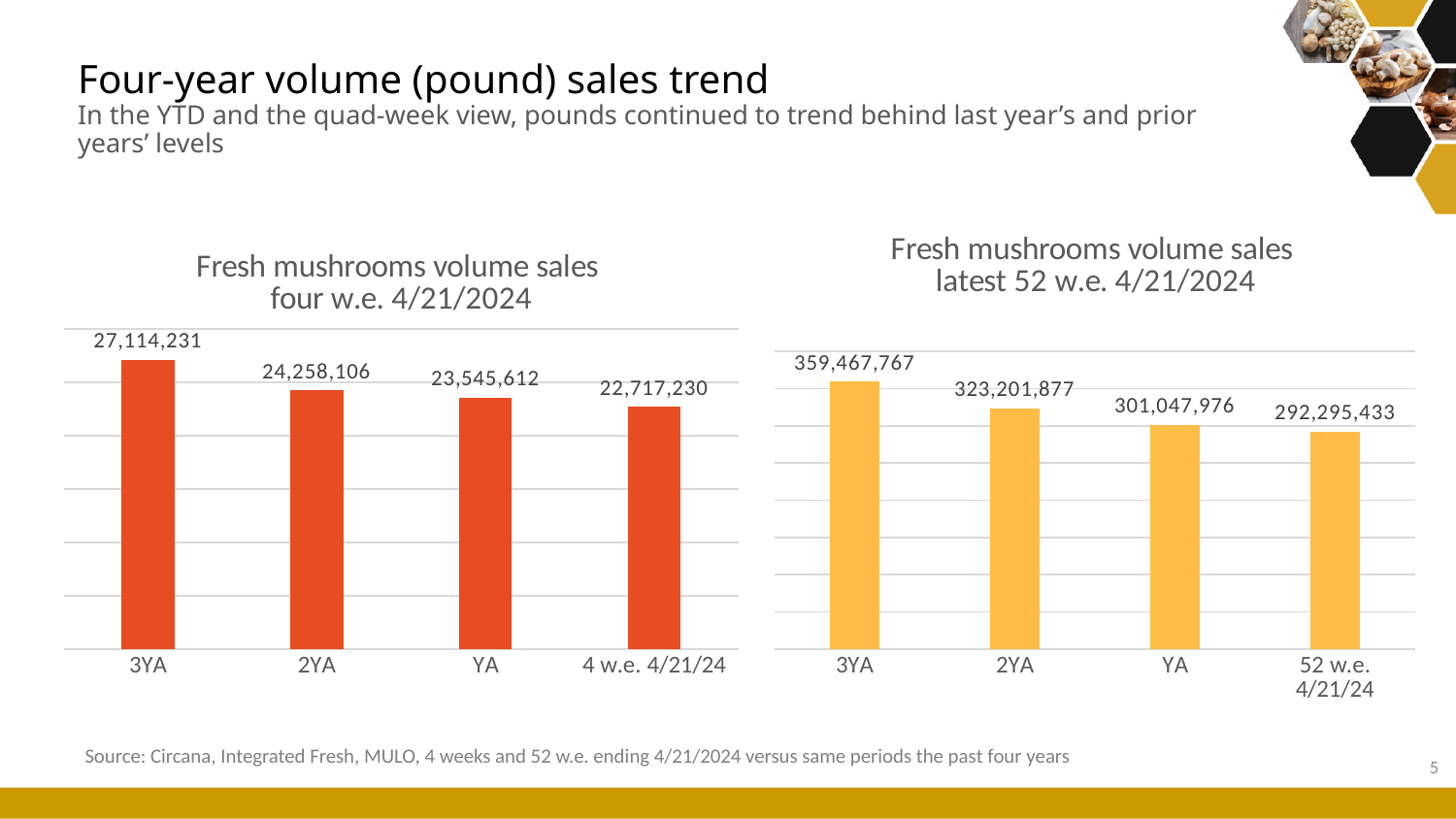
In the 'Fresh mushrooms volume sales four w.e. 4/21/2024' chart, which is larger, the value for 2YA or the value for YA? 2YA In the 'Fresh mushrooms volume sales four w.e. 4/21/2024' chart, what is the value for 3YA? 27,114,231 In the 'Fresh mushrooms volume sales four w.e. 4/21/2024' chart, which category has the highest value? 3YA How many categories are shown in the 'Fresh mushrooms volume sales latest 52 w.e. 4/21/2024' chart? 4 In the 'Fresh mushrooms volume sales four w.e. 4/21/2024' chart, what is the difference between the 3YA value and the 4 w.e. 4/21/24 value? 4,397,001 In the 'Fresh mushrooms volume sales four w.e. 4/21/2024' chart, what is the value for 4 w.e. 4/21/24? 22,717,230 What kind of chart is the 'Fresh mushrooms volume sales four w.e. 4/21/2024' chart? Bar chart In the 'Fresh mushrooms volume sales latest 52 w.e. 4/21/2024' chart, what is the difference between the 2YA value and the YA value? 22,153,901 In the 'Fresh mushrooms volume sales latest 52 w.e. 4/21/2024' chart, do the values rise or fall from 3YA to 52 w.e. 4/21/24? Fall In the 'Fresh mushrooms volume sales latest 52 w.e. 4/21/2024' chart, what is the value for YA? 301,047,976 In the 'Fresh mushrooms volume sales latest 52 w.e. 4/21/2024' chart, what is the value for 2YA? 323,201,877 In the 'Fresh mushrooms volume sales latest 52 w.e. 4/21/2024' chart, which category has the lowest value? 52 w.e. 4/21/24